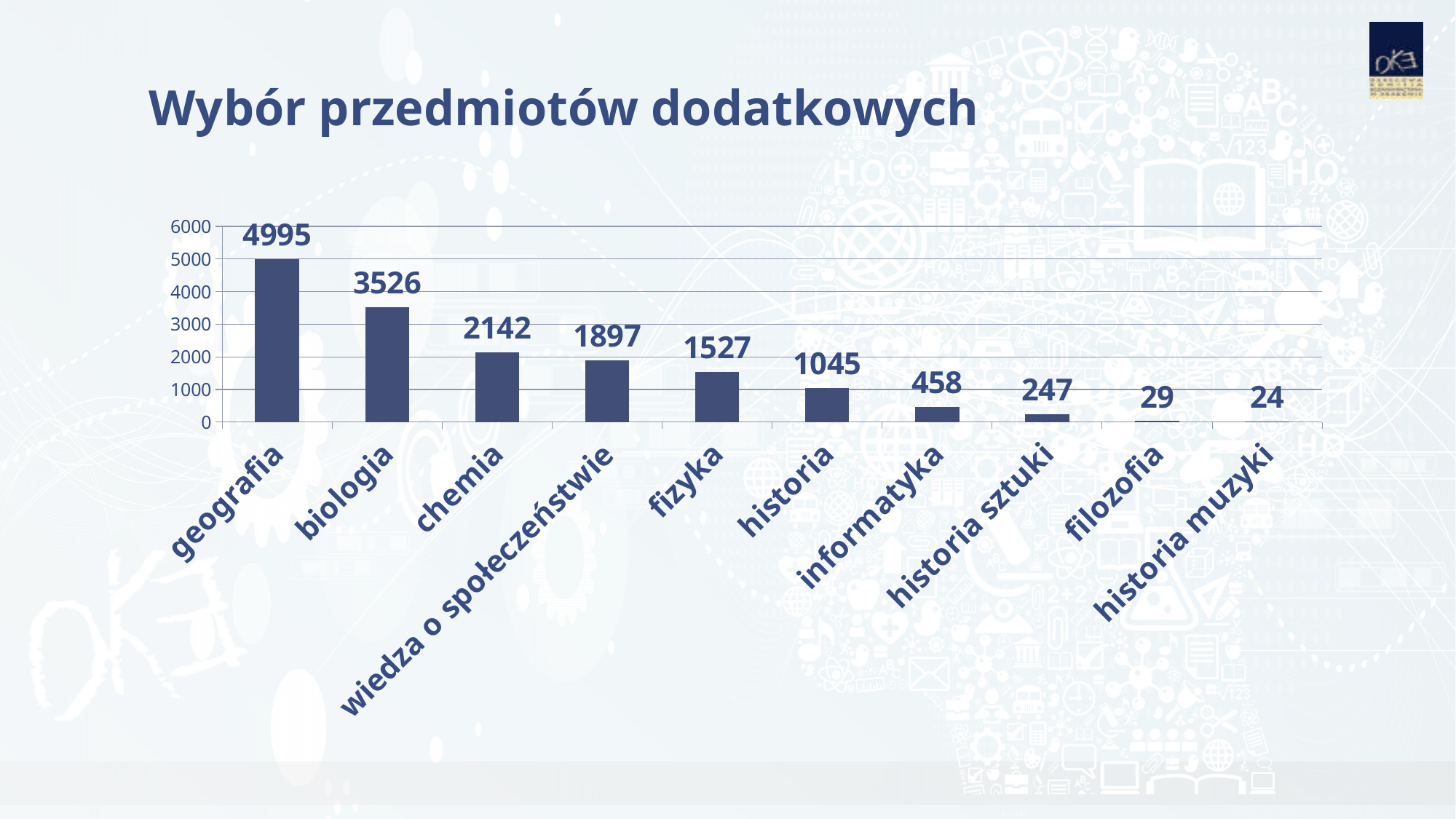
What is the value for wiedza o społeczeństwie? 1897 Which subject has the highest value? geografia Which subject has the lowest value? historia muzyki What is the difference between the values for geografia and biologia? 1469 What is the value for geografia? 4995 Which is larger, the value for historia or the value for informatyka? historia What is the difference between the values for chemia and fizyka? 615 What is the value for historia sztuki? 247 How many subjects are shown on the chart? 10 What is the title of the slide? Wybór przedmiotów dodatkowych What kind of chart is shown on the slide? bar chart Is the value for biologia greater or less than 3000? greater